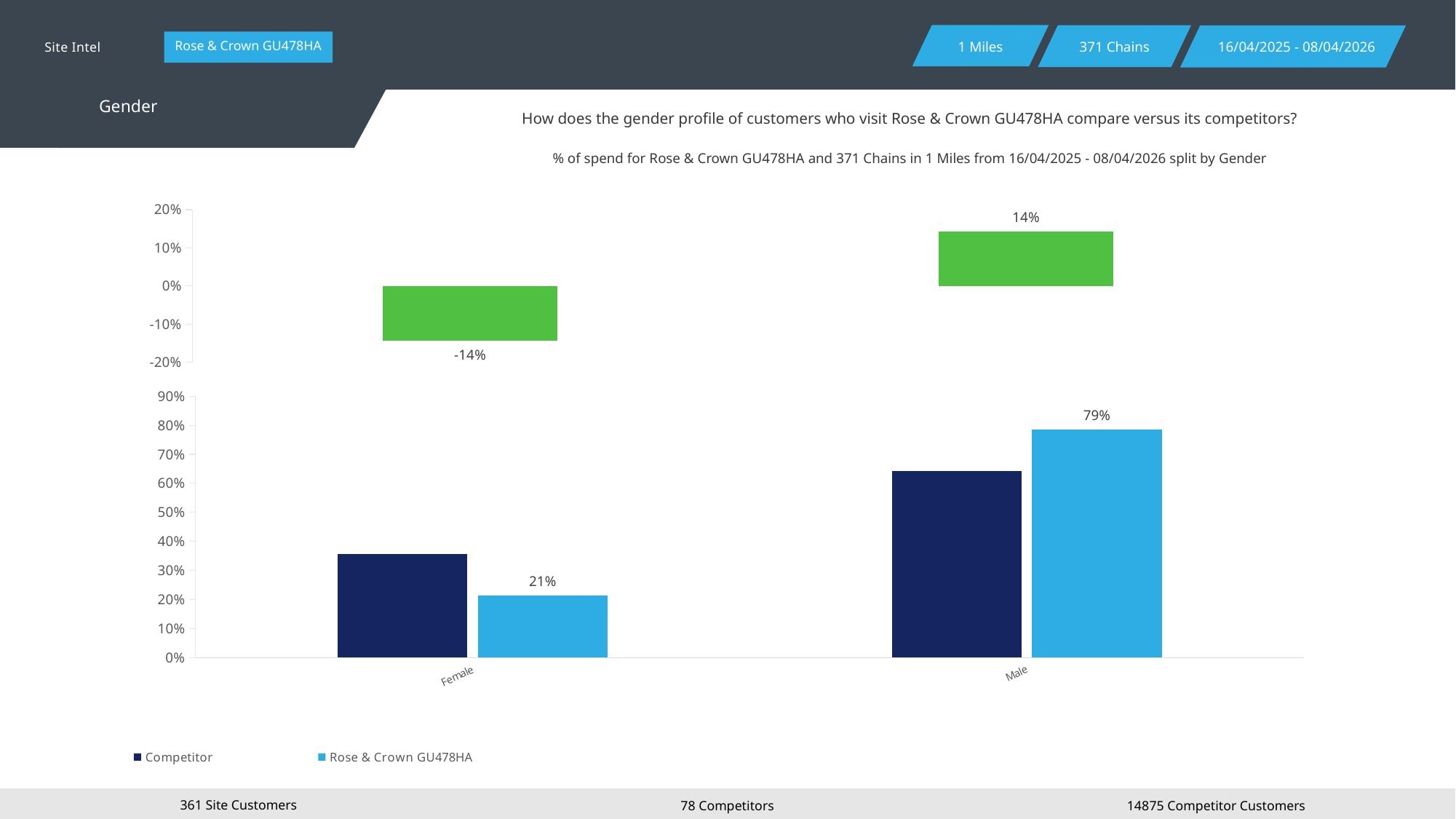
In the bottom chart, is the Competitor value for Male greater or less than 70%? less In the bottom chart, which is larger for Female: Competitor or Rose & Crown GU478HA? Competitor In the bottom chart, what is the difference between the Rose & Crown GU478HA values for Male and Female? 58% In the bottom chart, is the Competitor value for Female greater or less than 30%? greater In the top chart, what is the value shown for Female? -14% In the bottom chart, what is the value for Rose & Crown GU478HA for Male? 79% In the bottom chart, which is larger for Male: Competitor or Rose & Crown GU478HA? Rose & Crown GU478HA How many categories are shown on the x axis of the bottom chart? 2 How many series does the legend of the bottom chart list? 2 In the top chart, what is the value shown for Male? 14% In the bottom chart, what is the value for Rose & Crown GU478HA for Female? 21% What type of chart is the bottom chart? Bar chart